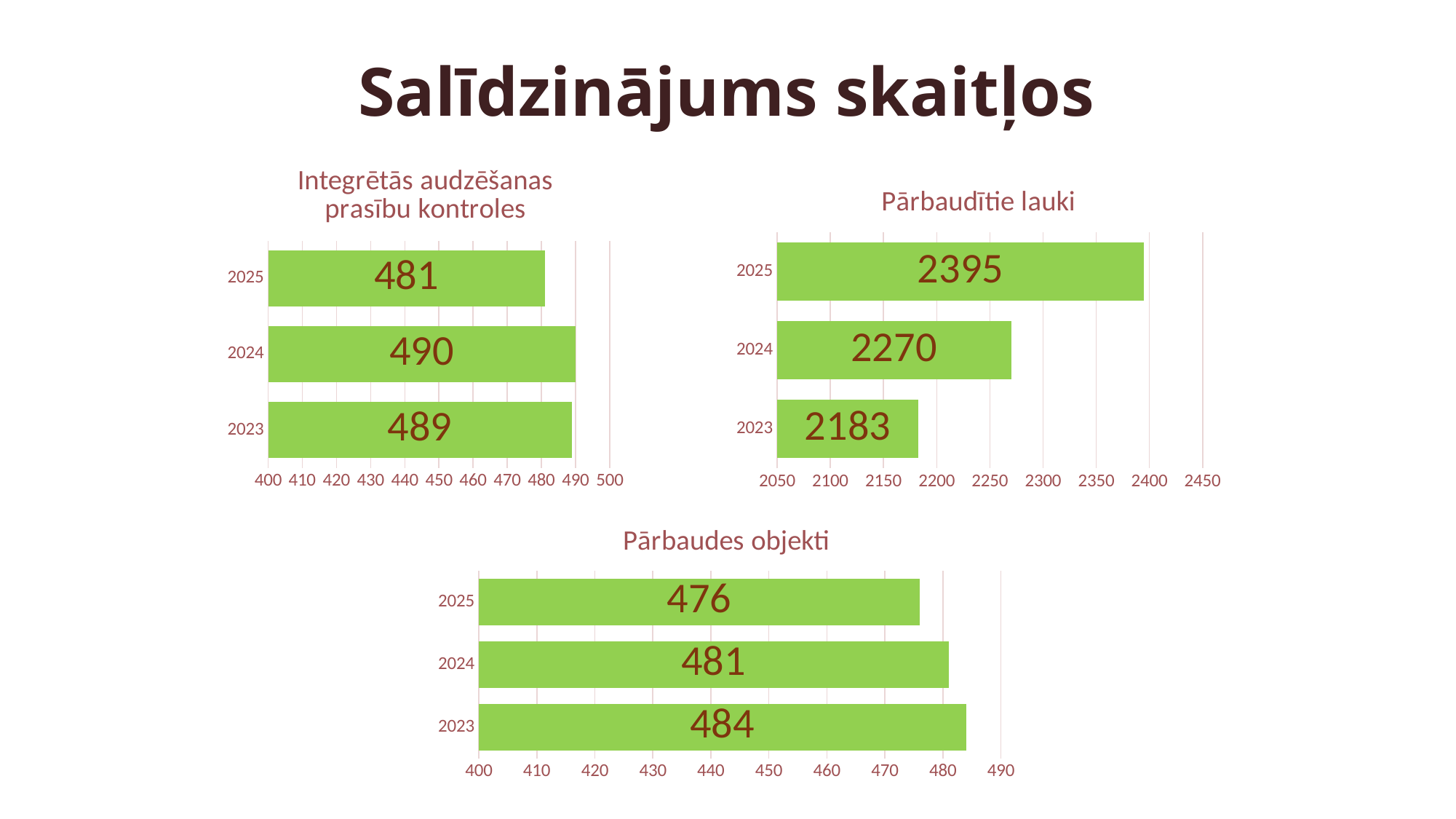
In the 'Pārbaudītie lauki' chart, do the values rise or fall from 2023 to 2025? rise In the 'Integrētās audzēšanas prasību kontroles' chart, which year has the highest value? 2024 In the 'Integrētās audzēšanas prasību kontroles' chart, what is the value for 2025? 481 In the 'Pārbaudes objekti' chart, what is the difference between the 2023 and 2025 values? 8 In the 'Pārbaudes objekti' chart, which is larger, the value for 2023 or the value for 2025? 2023 In the 'Pārbaudītie lauki' chart, what is the value for 2023? 2183 In the 'Pārbaudītie lauki' chart, which year has the lowest value? 2023 In the 'Pārbaudes objekti' chart, what is the value for 2024? 481 In the 'Integrētās audzēšanas prasību kontroles' chart, what is the difference between the 2024 and 2025 values? 9 How many bars does the 'Pārbaudes objekti' chart show? 3 What type of chart is the 'Pārbaudītie lauki' chart? bar chart In the 'Pārbaudītie lauki' chart, what is the difference between the 2025 and 2024 values? 125